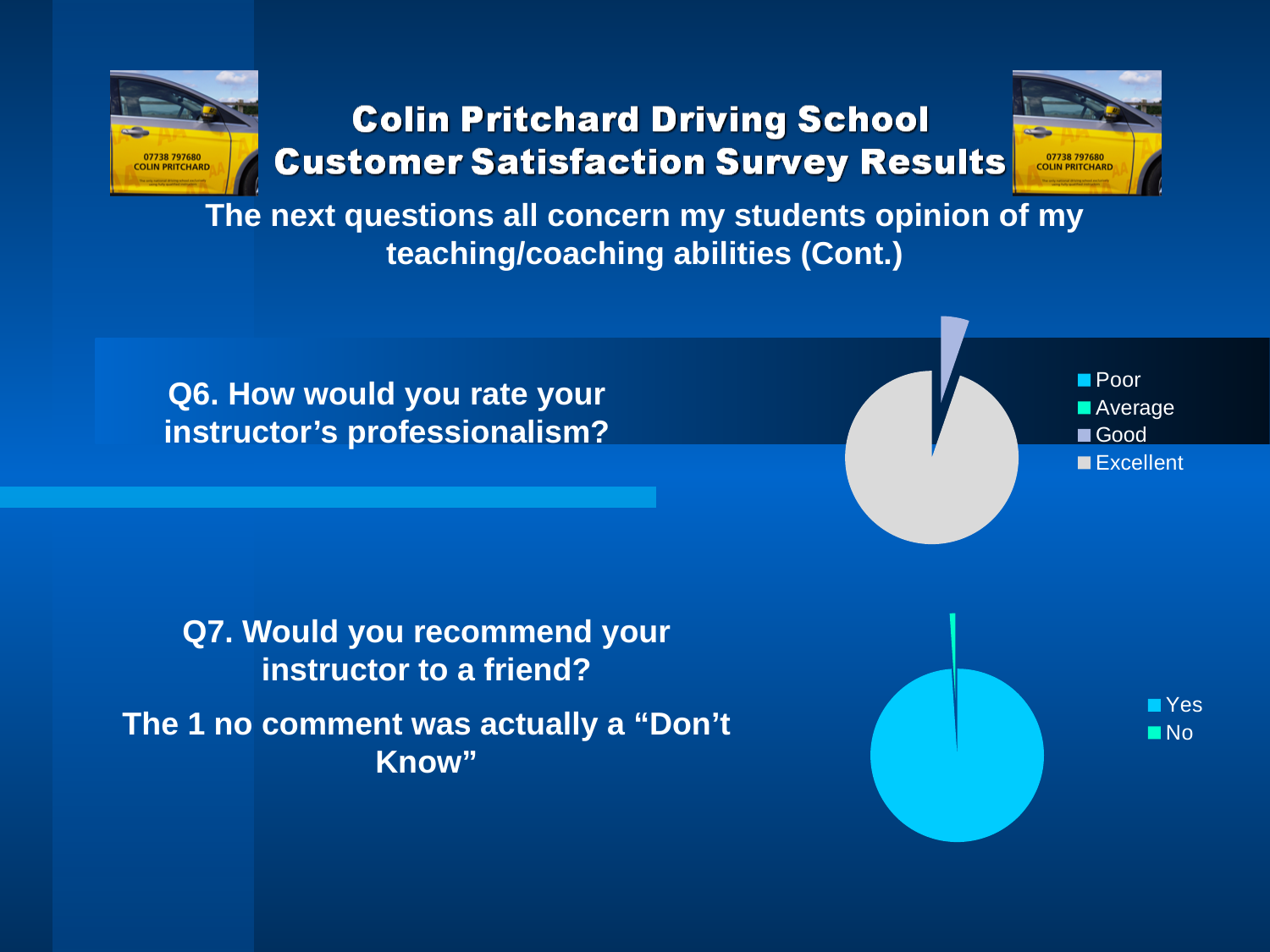
In the bottom chart (Q7, recommend to a friend), which response takes up the smallest share of the pie? No In the top chart (Q6, instructor's professionalism), how many entries does the legend list? 4 In the bottom chart (Q7, recommend to a friend), which response takes up the largest share of the pie? Yes In the bottom chart (Q7, recommend to a friend), what are the two legend entries? Yes, No In the top chart (Q6, instructor's professionalism), which rating takes up the largest share of the pie? Excellent In the bottom chart (Q7, recommend to a friend), how many entries does the legend list? 2 What kind of chart is shown next to Q7 (the bottom chart)? pie chart In the bottom chart (Q7, recommend to a friend), which is larger: the Yes slice or the No slice? Yes What kind of chart is shown next to Q6 (the top chart)? pie chart In the top chart (Q6, instructor's professionalism), which is larger: the Excellent slice or the Good slice? Excellent In the top chart (Q6, instructor's professionalism), what are the four legend entries? Poor, Average, Good, Excellent